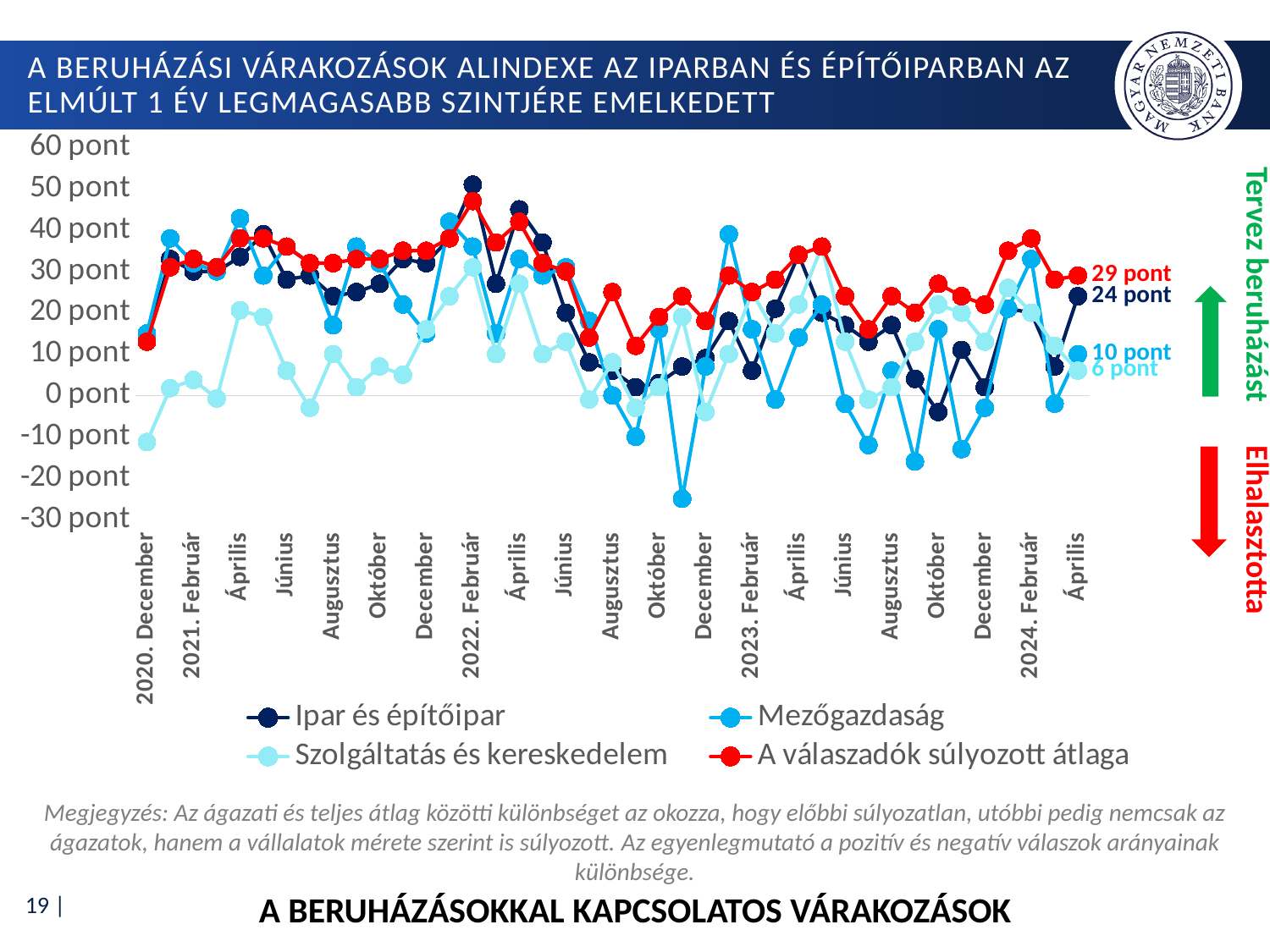
What is the difference between the final labelled values of 'A válaszadók súlyozott átlaga' and 'Ipar és építőipar'? 5 pont What kind of chart is shown on the slide? line chart What is the final labelled value of the 'Mezőgazdaság' series? 10 pont Which series has the highest value at the last data point (2024 Április)? A válaszadók súlyozott átlaga How many series does the chart legend list? 4 What is the final labelled value of the 'Szolgáltatás és kereskedelem' series? 6 pont What is the final labelled value of the 'Ipar és építőipar' series? 24 pont Which series has the lowest value at the last data point (2024 Április)? Szolgáltatás és kereskedelem What is the final labelled value of the 'A válaszadók súlyozott átlaga' series? 29 pont Which series is drawn in red? A válaszadók súlyozott átlaga At the last data point, which is larger: 'Ipar és építőipar' or 'Mezőgazdaság'? Ipar és építőipar Is the lowest value of the 'Mezőgazdaság' series greater or less than -20 pont? less